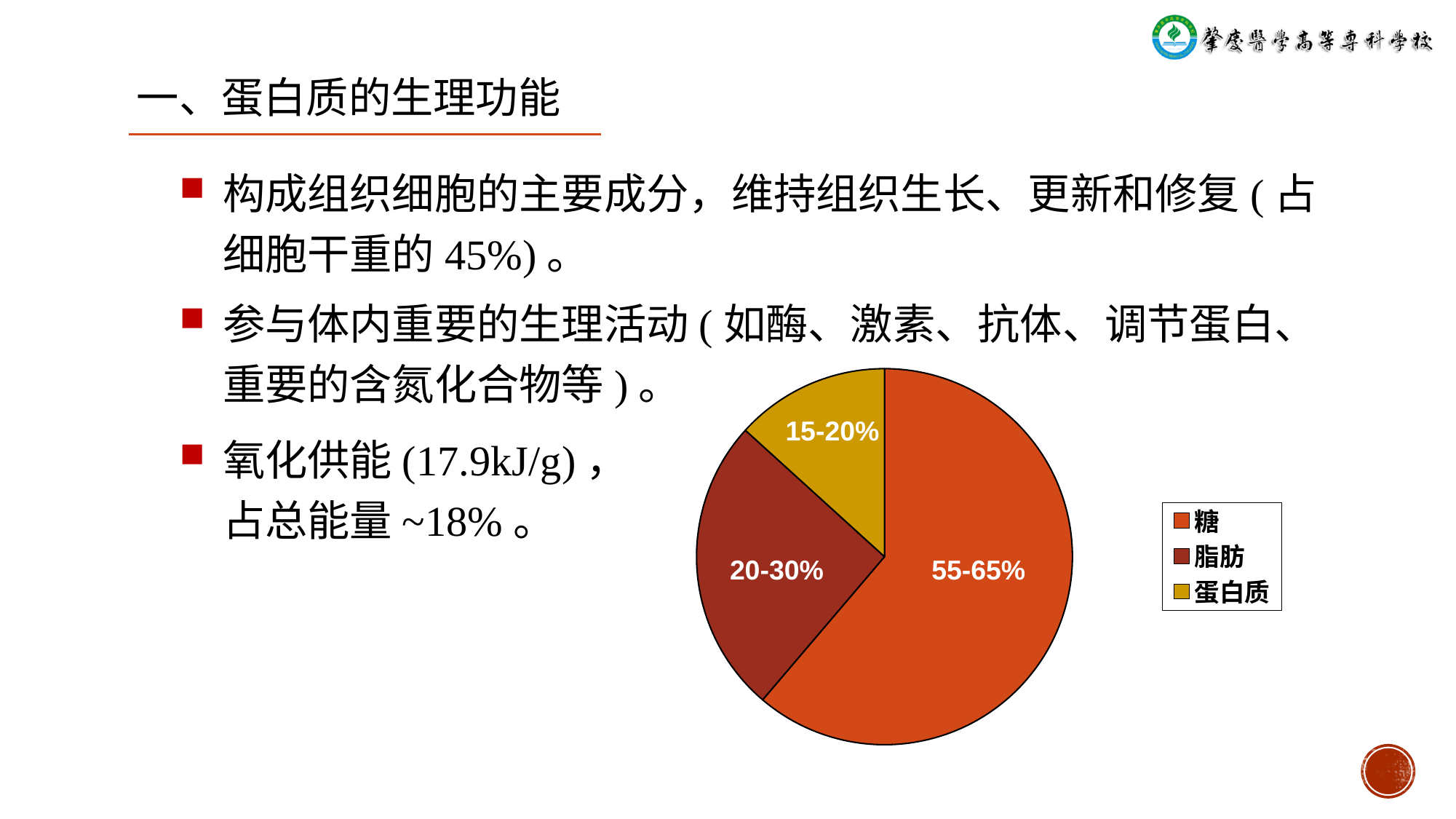
Which legend entry is listed first in the pie chart's legend? 糖 How many slices does the pie chart have? 3 Which category has the smallest slice in the pie chart? 蛋白质 What kind of chart is shown on the slide? pie chart What is the label shown on the 糖 slice of the pie chart? 55-65% Which slice is larger in the pie chart, 脂肪 or 蛋白质? 脂肪 Which category is shown in yellow in the pie chart? 蛋白质 Which slice is larger in the pie chart, 糖 or 脂肪? 糖 What is the label shown on the 脂肪 slice of the pie chart? 20-30% What is the label shown on the 蛋白质 slice of the pie chart? 15-20% Which category has the largest slice in the pie chart? 糖 How many entries does the legend of the pie chart list? 3